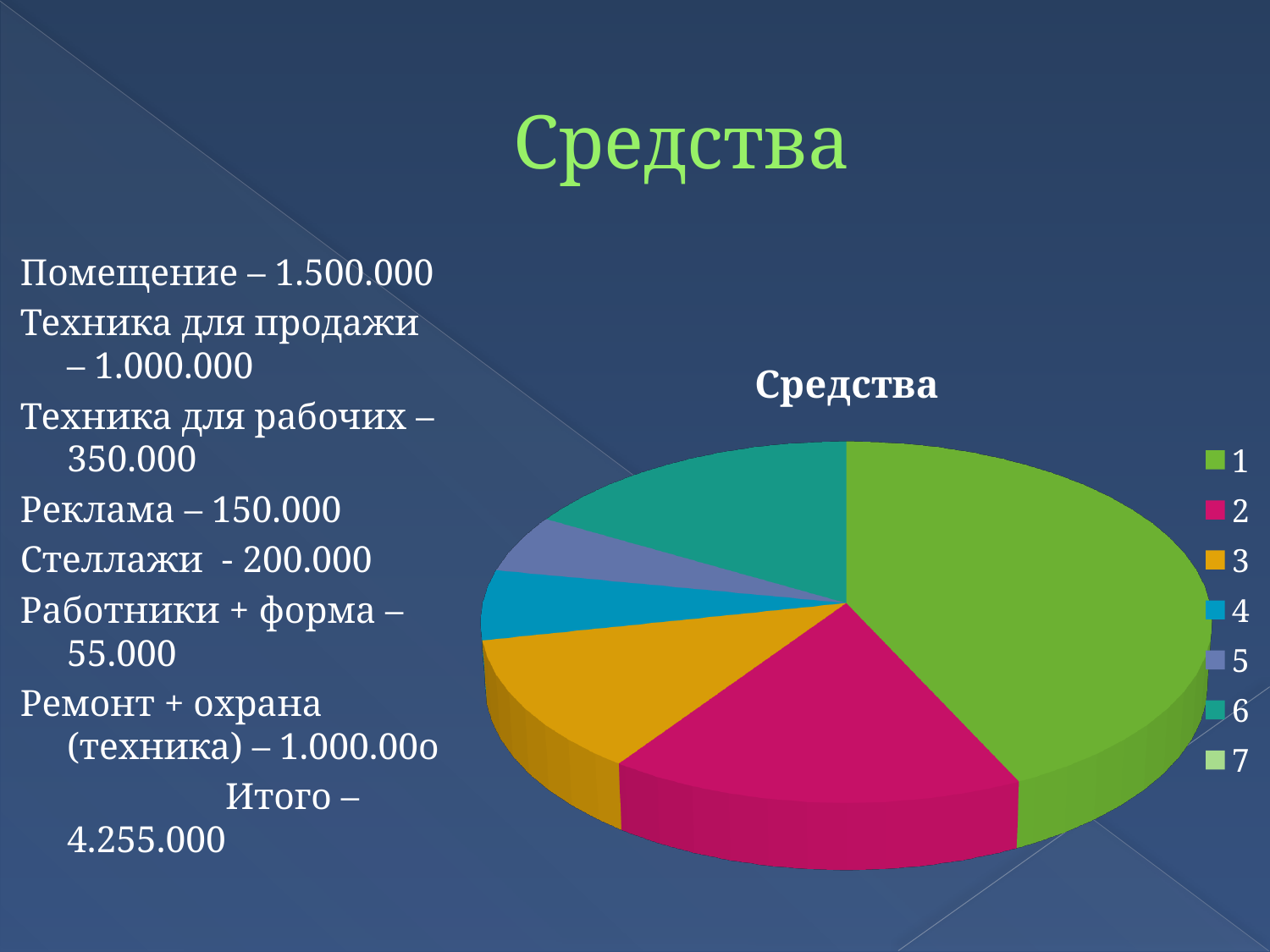
Which slice is larger, category 3 or category 4? 3 What kind of chart is shown on the slide? pie chart How many entries does the chart's legend list? 7 What is the title of the chart? Средства Which slice is larger, category 2 or category 3? 2 Which category has the largest slice of the pie? 1 Which slice is larger, category 1 or category 2? 1 What colour is the slice for category 1 in the pie chart? green